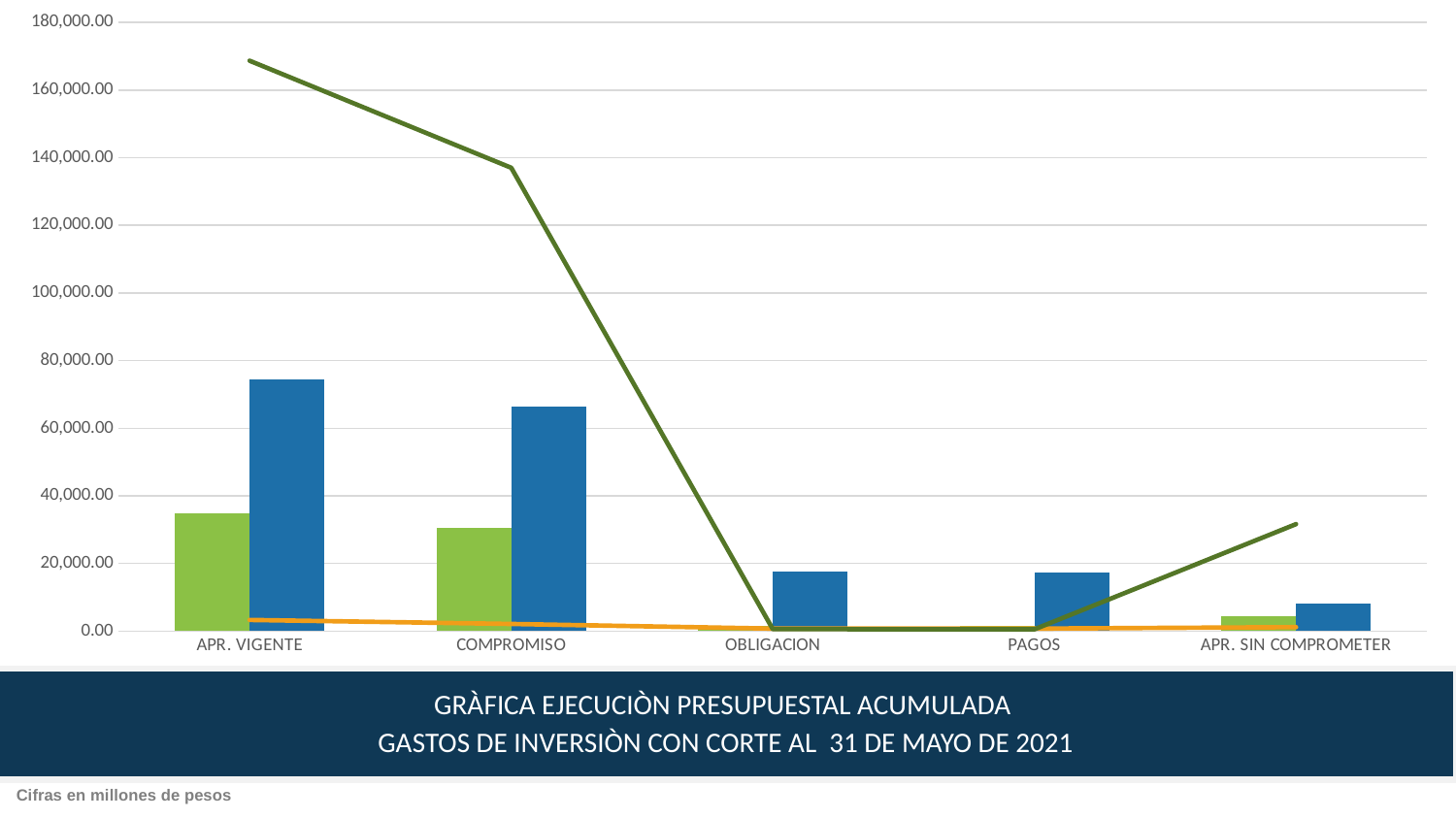
What kind of chart is shown on the slide? A combination bar and line chart According to the note below the chart, in what units are the figures expressed? Millones de pesos Is the blue bar for COMPROMISO greater or less than 80,000.00? less Is the dark green line value at COMPROMISO greater or less than 140,000.00? less Which category has the shortest blue bar? APR. SIN COMPROMETER Which category has the tallest blue bar? APR. VIGENTE Does the dark green line rise or fall from APR. VIGENTE to PAGOS? It falls How many categories are shown on the x axis? 5 Is the dark green line value at APR. VIGENTE greater or less than 160,000.00? greater Which is larger, the blue bar for APR. VIGENTE or the blue bar for COMPROMISO? APR. VIGENTE